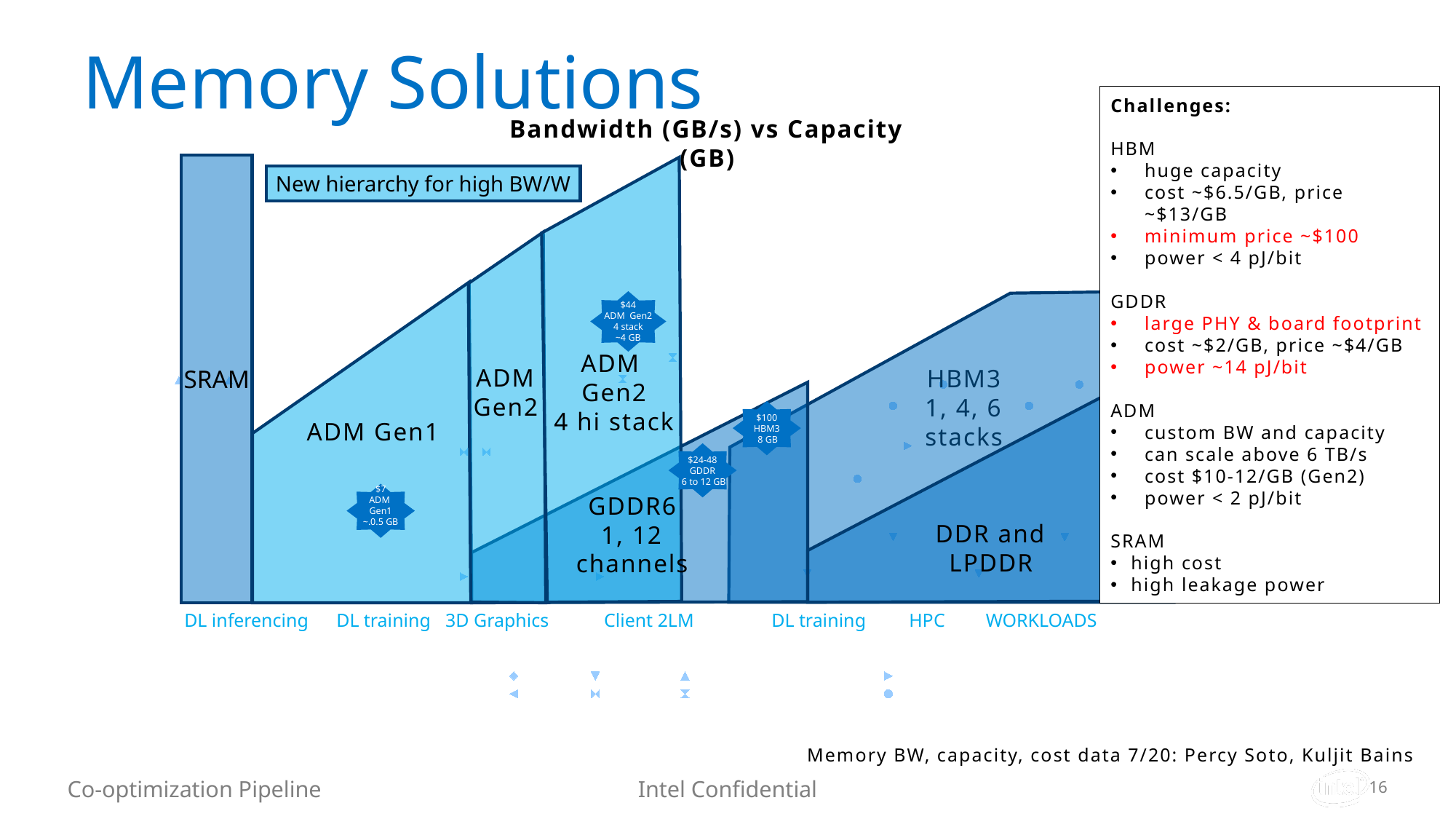
What price is shown in the callout for ADM Gen2 4 stack (~4 GB)? $44 What price is shown in the callout for HBM3 8 GB? $100 What price range is shown in the callout for GDDR (6 to 12 GB)? $24-48 What is the difference between the callout prices for HBM3 8 GB and ADM Gen2 4 stack? $56 Which memory type has the highest callout price on the chart? HBM3 8 GB Which memory type has the lowest callout price on the chart? ADM Gen1 What price is shown in the callout for ADM Gen1 (~.0.5 GB)? $7 What is the title of the chart on the slide? Bandwidth (GB/s) vs Capacity (GB) What is the difference between the callout prices for ADM Gen2 4 stack and ADM Gen1? $37 Which memory type is shown in the leftmost region of the chart? SRAM Which memory type has the higher callout price, HBM3 8 GB or ADM Gen2 4 stack? HBM3 8 GB